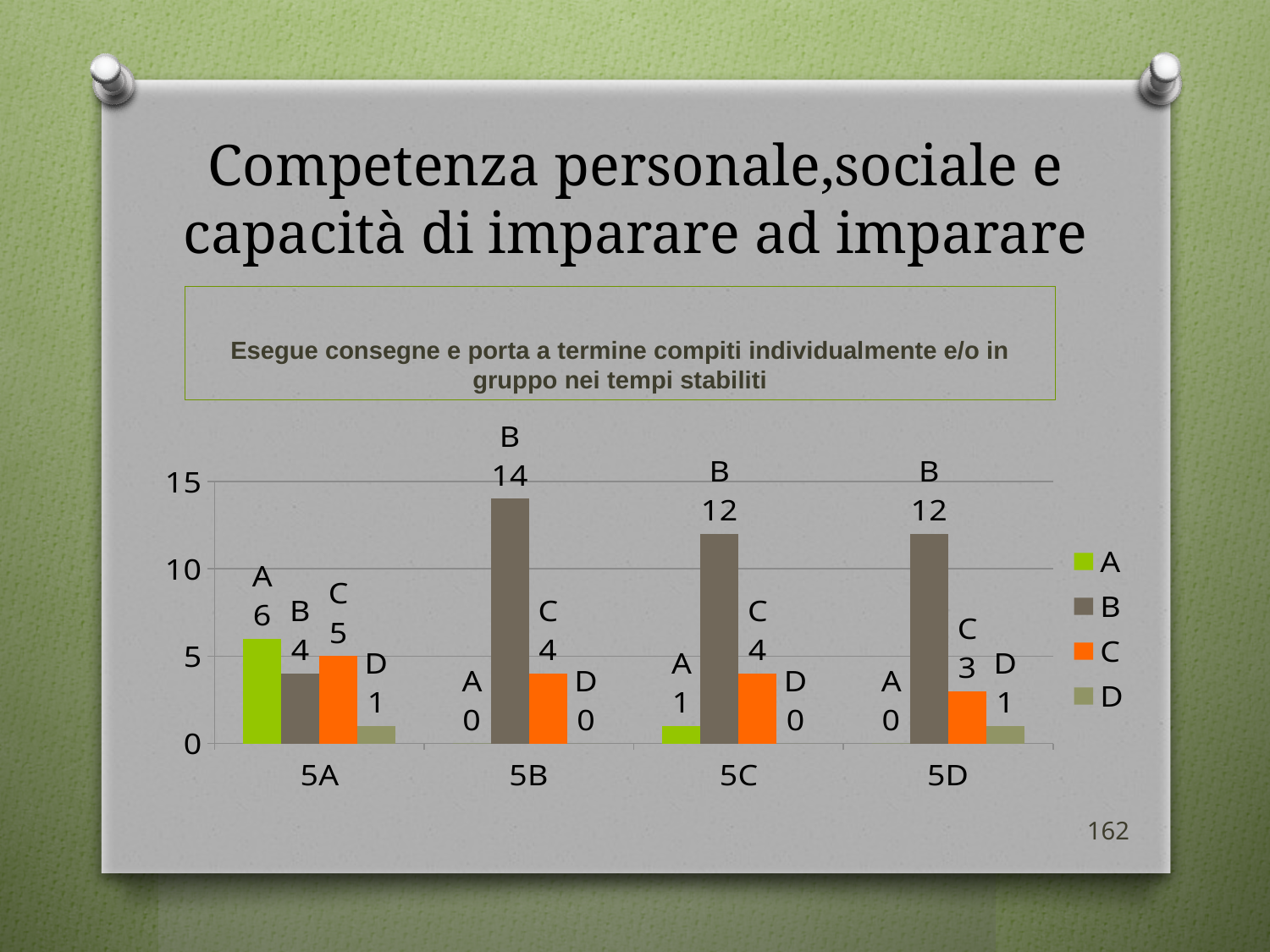
What is the total of all four series in category 5A? 16 What is the value for series A in category 5A? 6 Which category has the lowest value for series C? 5D What is the value for series C in category 5D? 3 What is the value for series D in category 5C? 0 Which is larger: the value for series A in 5A or the value for series C in 5A? A in 5A What is the value for series B in category 5B? 14 Which category has the highest value for series B? 5B How many categories are shown on the x axis? 4 How many series does the legend list? 4 What is the difference between the value for series B in 5B and the value for series B in 5C? 2 What kind of chart is shown on the slide? bar chart